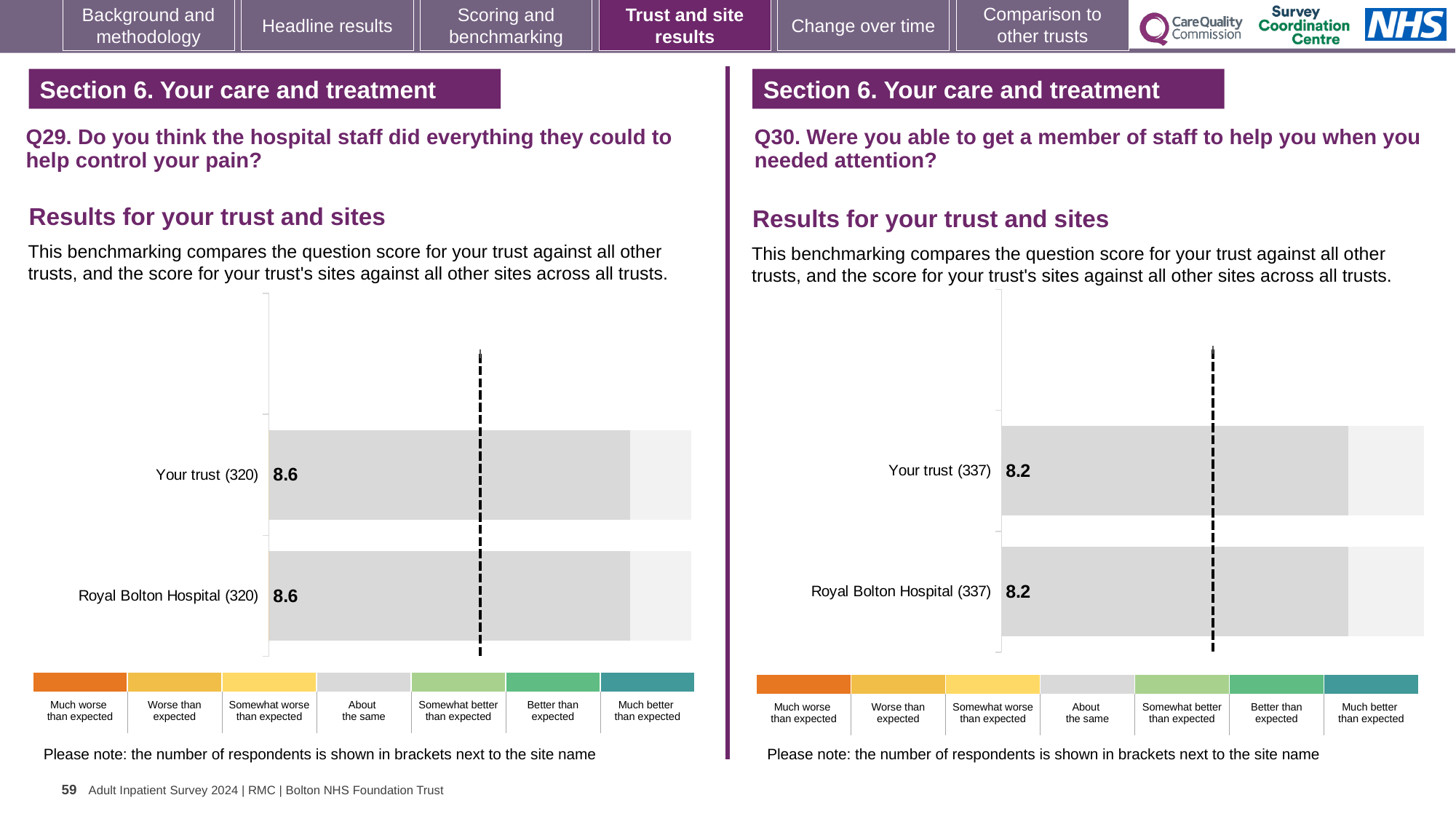
What kind of chart is the Q29 chart on the left? Bar chart In the Q29 chart on the left, what is the difference between the score for Your trust (320) and Royal Bolton Hospital (320)? 0 In the Q30 chart on the right, what is the difference between the score for Your trust (337) and Royal Bolton Hospital (337)? 0 Which is larger: the Your trust score in the Q29 chart on the left or the Your trust score in the Q30 chart on the right? Q29 chart (8.6) In the Q30 chart on the right, what is the score for Royal Bolton Hospital (337)? 8.2 In the Q30 chart on the right, what is the score for Your trust (337)? 8.2 In the Q29 chart on the left, what is the score for Royal Bolton Hospital (320)? 8.6 In the Q29 chart on the left, how many respondents are shown in brackets next to Royal Bolton Hospital? 320 In the Q29 chart on the left, what is the score for Your trust (320)? 8.6 In the Q30 chart on the right, how many bars are plotted? 2 In the Q30 chart on the right, how many categories does the colour key below the chart list? 7 In the Q29 chart on the left, how many bars are plotted? 2